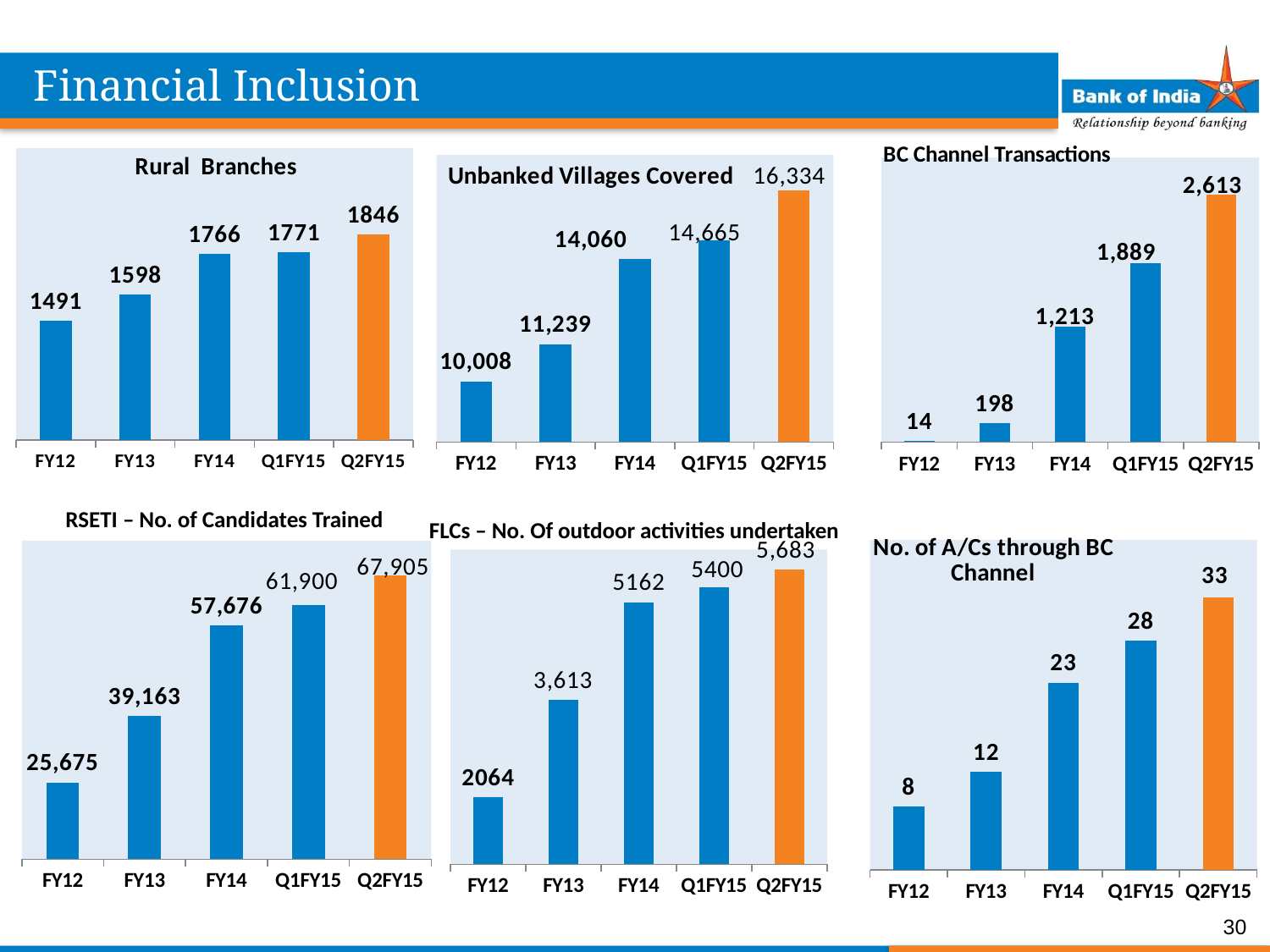
In the No. of A/Cs through BC Channel chart, what is the difference between Q1FY15 and FY14? 5 In the BC Channel Transactions chart, which category has the lowest value? FY12 In the FLCs – No. Of outdoor activities undertaken chart, which is larger, FY14 or Q1FY15? Q1FY15 In the RSETI – No. of Candidates Trained chart, what is the difference between Q2FY15 and FY12? 42,230 In the Unbanked Villages Covered chart, do the values rise or fall from FY12 to Q2FY15? Rise What kind of chart is the BC Channel Transactions chart? Bar chart How many categories are shown in the Rural Branches chart? 5 In the Unbanked Villages Covered chart, what is the value for Q2FY15? 16,334 In the BC Channel Transactions chart, what is the value for FY13? 198 In the Rural Branches chart, what colour is the Q2FY15 bar? Orange In the Rural Branches chart, what is the value for FY14? 1766 In the No. of A/Cs through BC Channel chart, which category has the highest value? Q2FY15